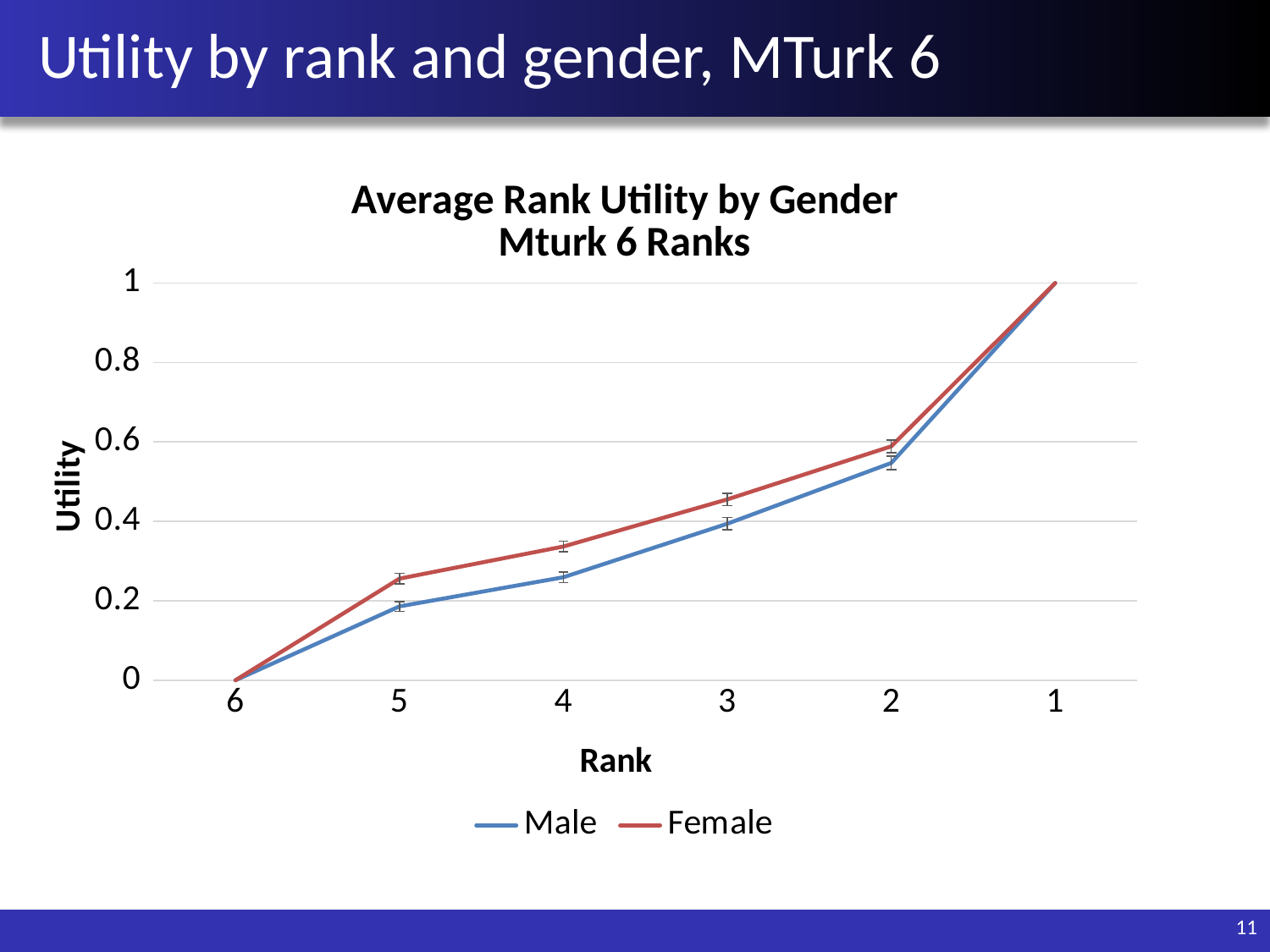
What kind of chart is shown on the slide? line chart What is the utility value for Male at rank 6? 0 How many series does the legend list? 2 At rank 4, which series has the higher utility, Male or Female? Female What is the utility value for Female at rank 1? 1 Do the utility values rise or fall moving from rank 6 to rank 1 along the x axis? rise How many rank categories are plotted along the x axis? 6 At which rank is the Female utility highest? 1 At which rank is the Male utility lowest? 6 Is the Female utility at rank 5 greater or less than 0.2? greater Is the Male utility at rank 5 greater or less than 0.2? less